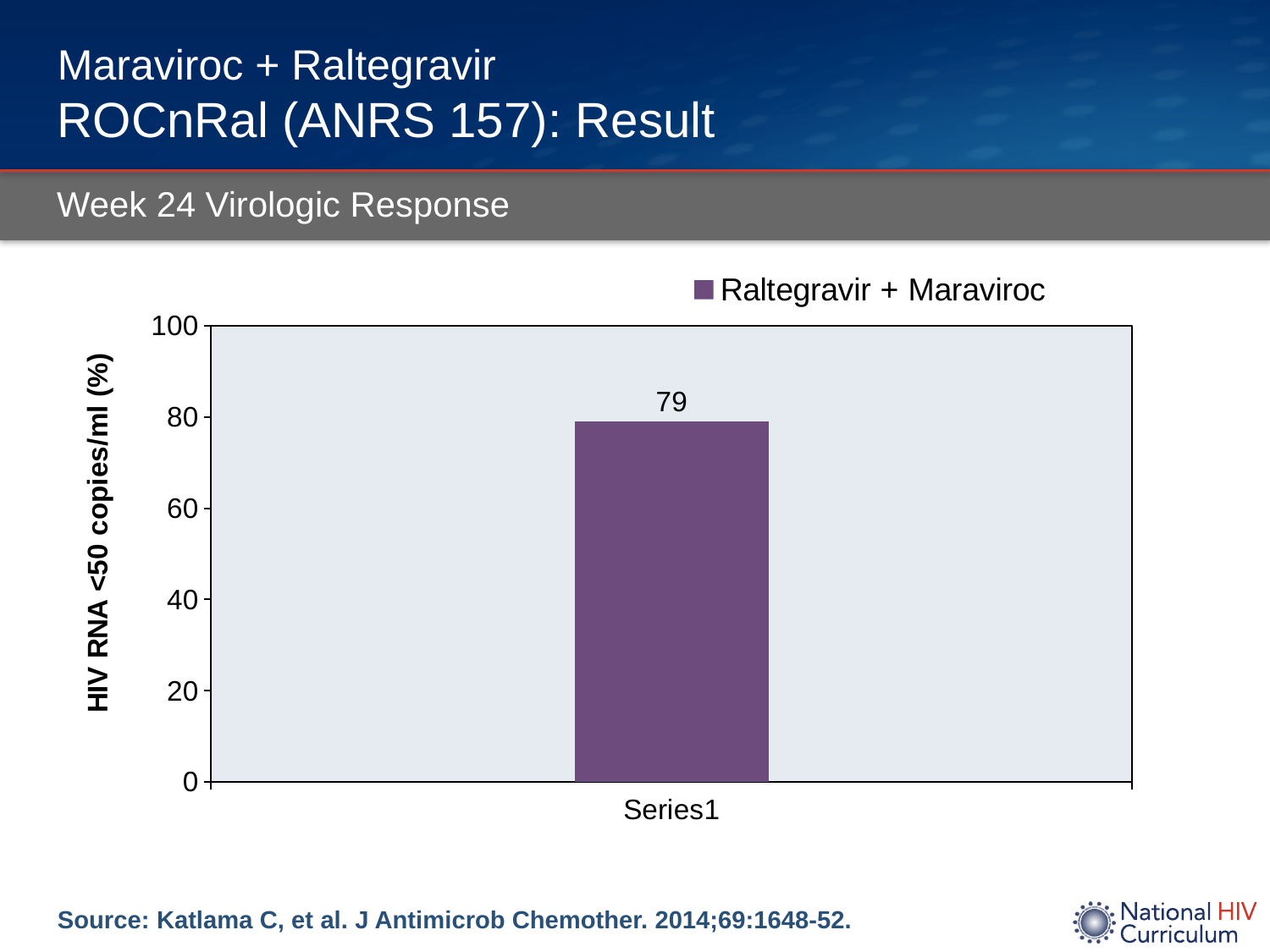
Is the value for Raltegravir + Maraviroc greater or less than 60? greater Is the value for Raltegravir + Maraviroc greater or less than 80? less What is the category label shown on the x axis? Series1 What kind of chart is shown on the slide? bar chart How many bars are plotted in the chart? 1 What is the label on the y axis? HIV RNA <50 copies/ml (%) What is the maximum value shown on the y axis? 100 What is the value for Raltegravir + Maraviroc? 79 How many series does the legend list? 1 What series name appears in the legend? Raltegravir + Maraviroc